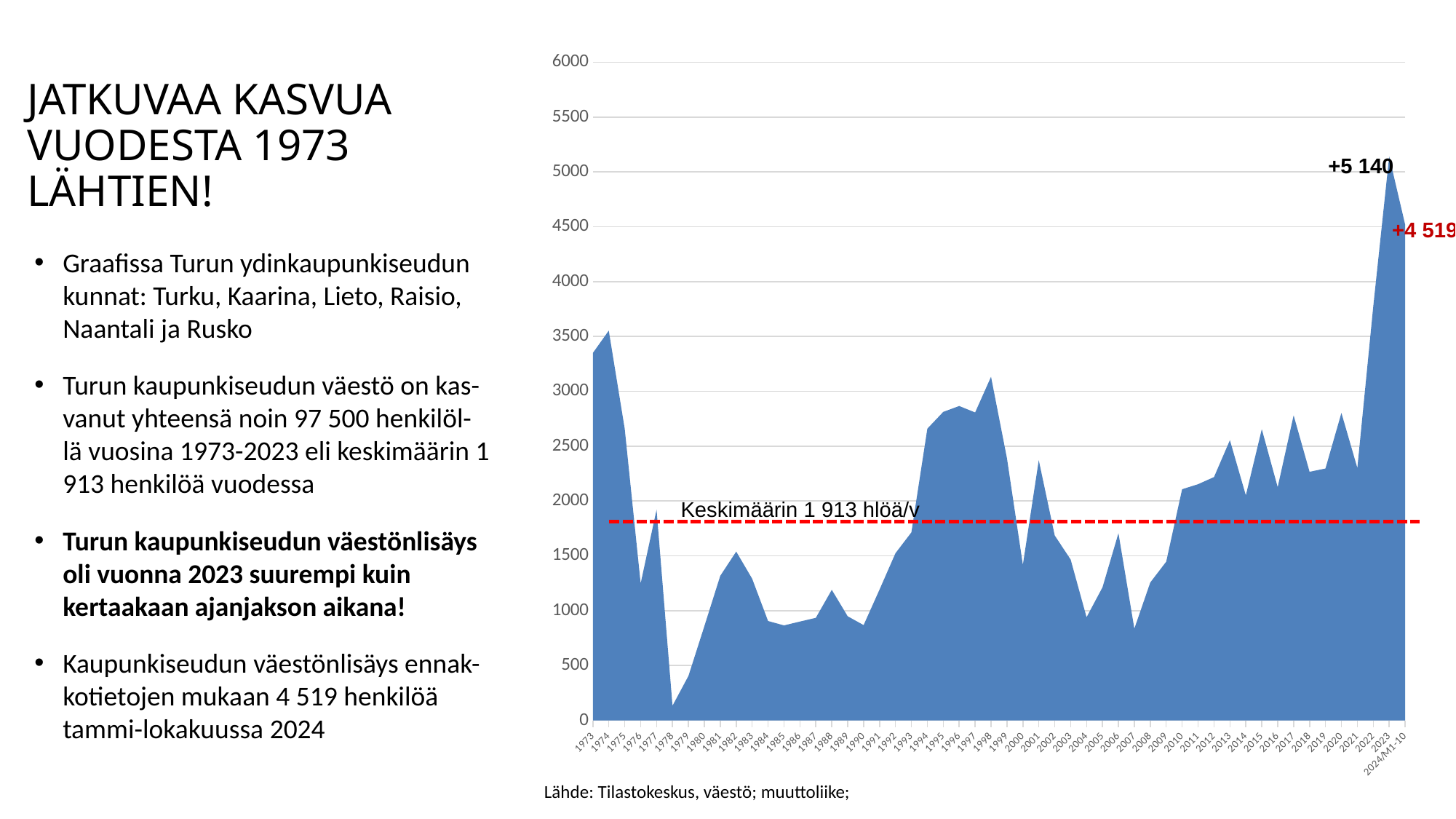
What kind of chart is shown on the slide? area chart Do the values fall or rise between 1973 and 1978? fall What is the difference between the labelled values for 2023 and 2024/M1-10? 621 What is the value labelled for 2024/M1-10? +4 519 Which year has the highest value in the chart? 2023 Which year has the lowest value in the chart? 1978 Which is larger, the value for 2023 or the value for 2024/M1-10? 2023 Is the value for 1978 greater or less than 500? less What does the label on the red dashed line say? Keskimäärin 1 913 hlöä/v What is the value labelled for 2023? +5 140 Is the value for 2007 greater or less than 1000? less Is the value for 1973 greater or less than 3000? greater